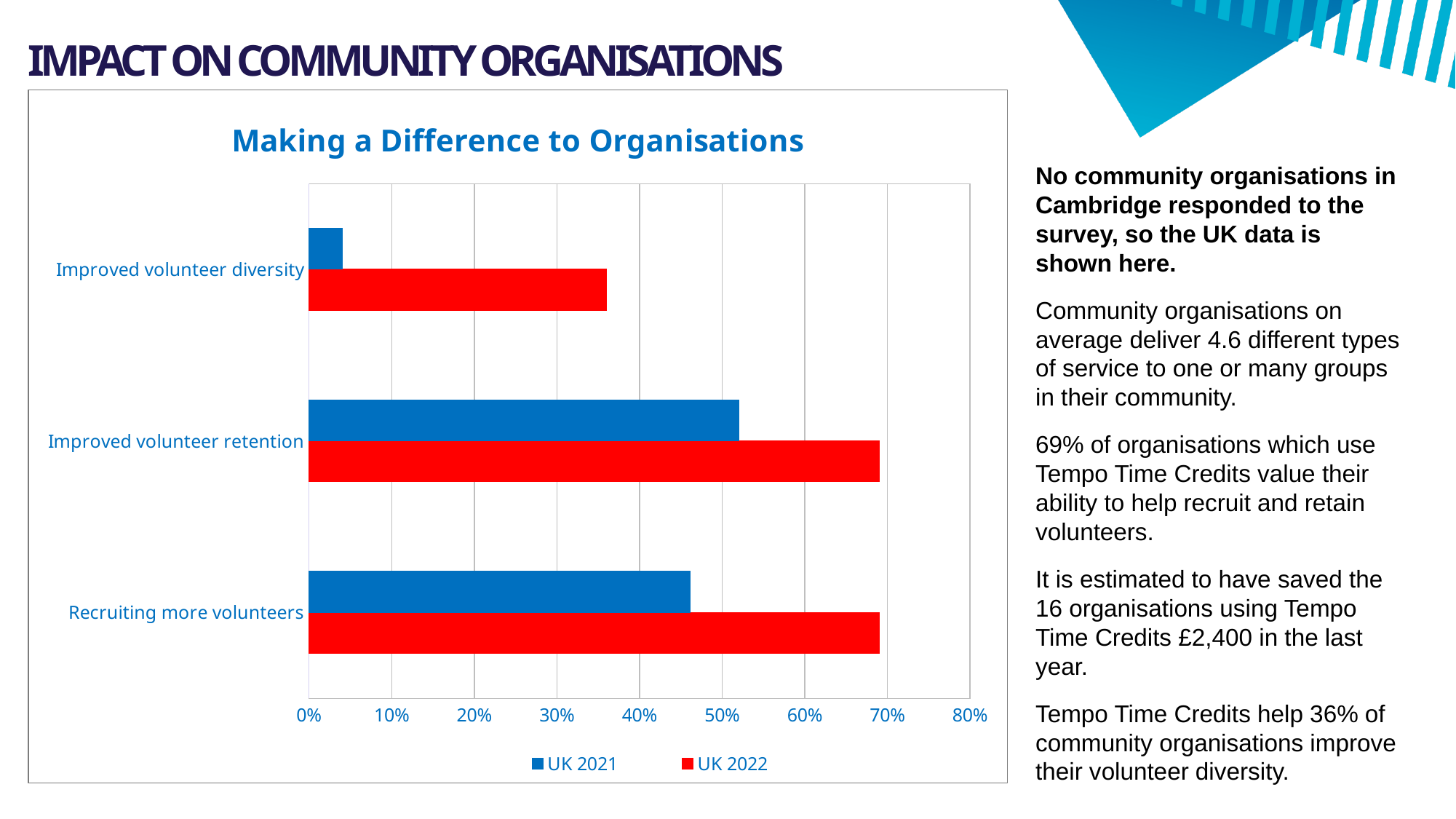
Which category has the lowest value for UK 2022? Improved volunteer diversity What kind of chart is shown on the slide? Bar chart What is the title of the chart? Making a Difference to Organisations Is the UK 2022 value for Improved volunteer retention greater or less than 60%? greater Is the UK 2021 value for Recruiting more volunteers greater or less than 50%? less Is the UK 2022 value for Improved volunteer diversity greater or less than 30%? greater How many series does the chart legend list? 2 For Recruiting more volunteers, which series has the larger value, UK 2021 or UK 2022? UK 2022 Which category has the highest value for UK 2021? Improved volunteer retention How many categories are shown on the chart? 3 Which category has the lowest value for UK 2021? Improved volunteer diversity